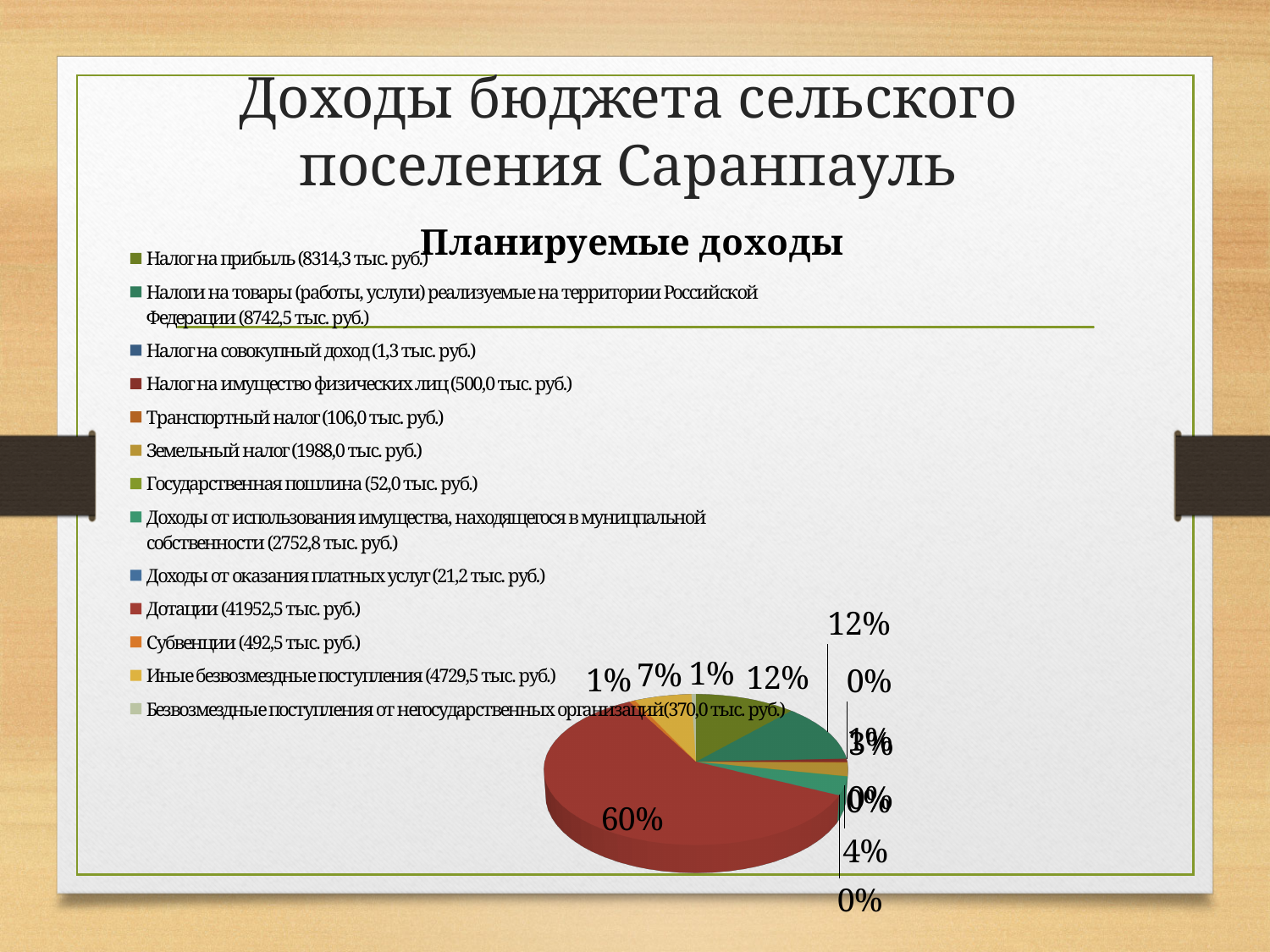
What amount is given for Дотации in the legend? 41952,5 тыс. руб. Which is larger, the slice for Дотации or the slice for Налог на прибыль? Дотации What is the difference between the amounts for Налоги на товары (работы, услуги) and Налог на прибыль shown in the legend? 428,2 тыс. руб. What kind of chart is shown on the slide? Pie chart What is the title of the chart? Планируемые доходы What amount is given for Транспортный налог in the legend? 106,0 тыс. руб. What share of the pie does Иные безвозмездные поступления take? 7% How many categories does the chart's legend list? 13 What amount is given for Налог на совокупный доход in the legend? 1,3 тыс. руб. What share of the pie does Дотации take? 60% Which category has the largest slice of the pie? Дотации Which category has the smallest amount according to the legend? Налог на совокупный доход